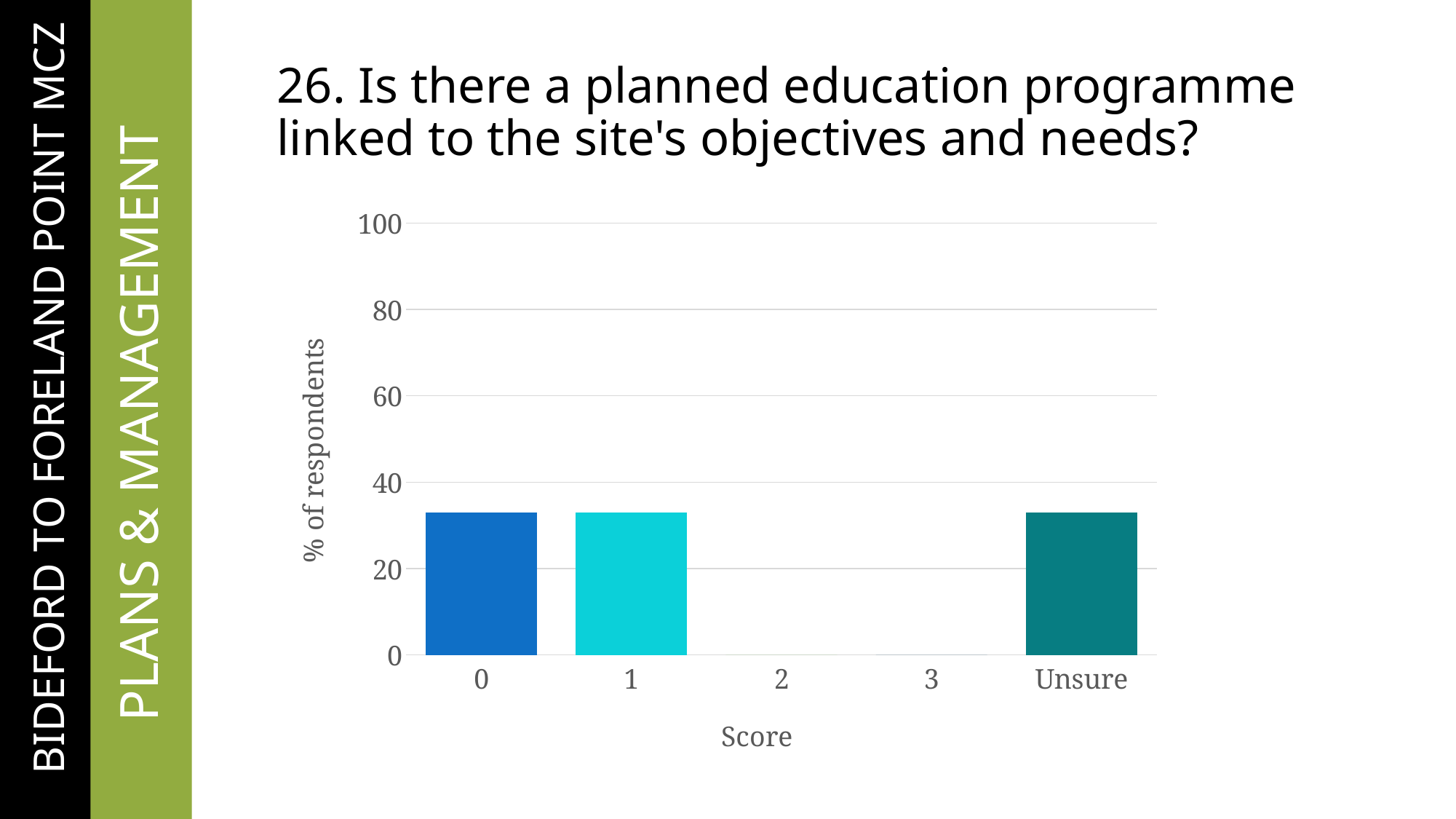
Is the value for score 1 greater or less than 20? greater How many score categories have a visible bar? 3 What is the title of the y axis? % of respondents What kind of chart is shown on the slide? bar chart Is the value for score 0 greater or less than 20? greater How many score categories are shown on the x axis? 5 Is the value for Unsure greater or less than 40? less What is the title of the x axis? Score Which is larger, the value for score 0 or the value for score 2? 0 Which is larger, the value for Unsure or the value for score 3? Unsure